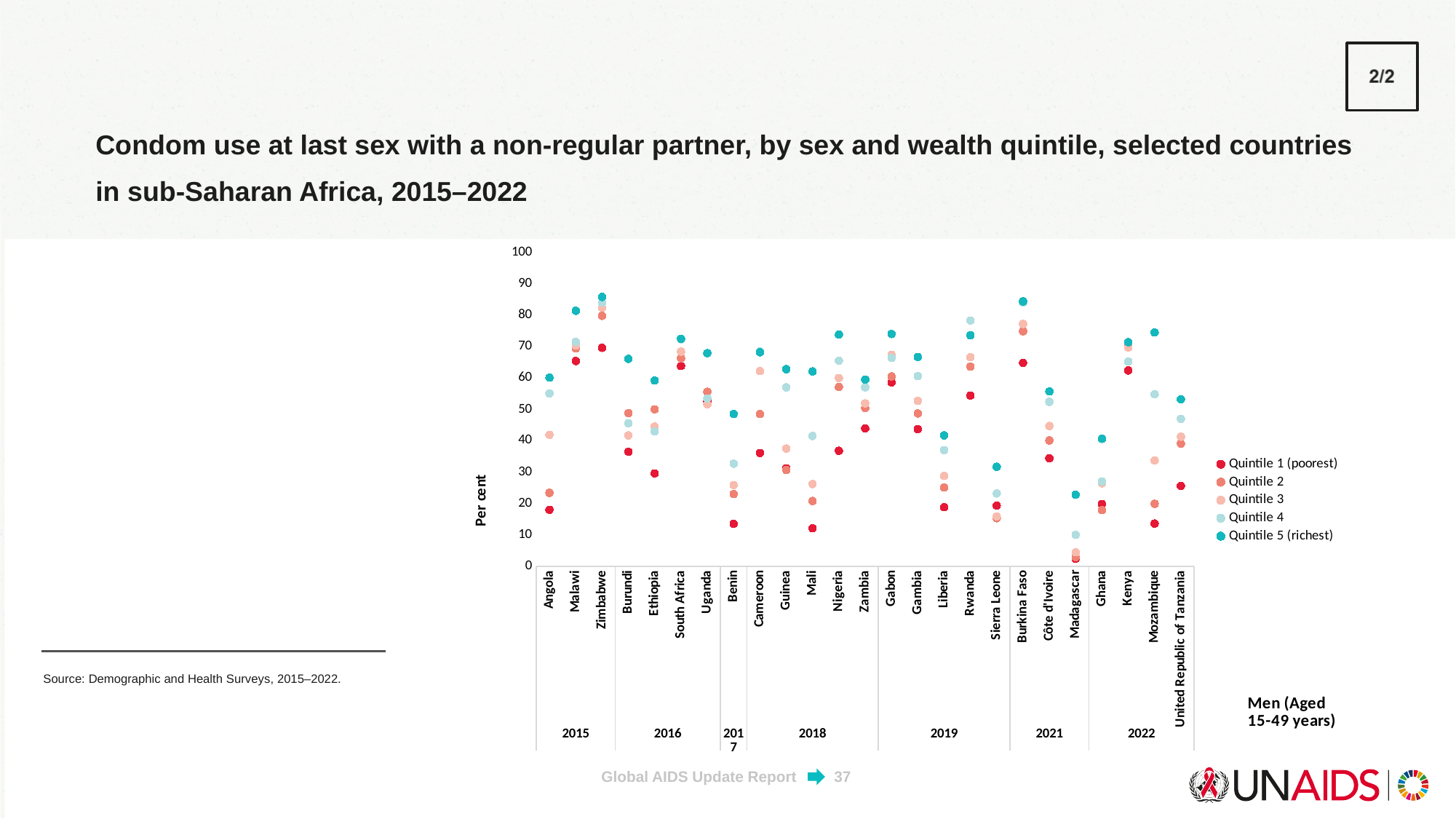
What kind of chart is shown on the slide? Scatter (dot) chart How many series does the legend list? 5 Which is larger, the Quintile 5 (richest) value for Malawi or for Angola? Malawi Is the Quintile 5 (richest) value for Burkina Faso greater or less than 80? greater Is the Quintile 5 (richest) value for Madagascar greater or less than 30? less Is the Quintile 1 (poorest) value for Mali greater or less than 20? less What is the label on the y axis of the chart? Per cent How many countries are shown along the x axis? 25 Which country has the lowest Quintile 1 (poorest) value? Madagascar Which is larger, the Quintile 1 (poorest) value for Mali or for Nigeria? Nigeria